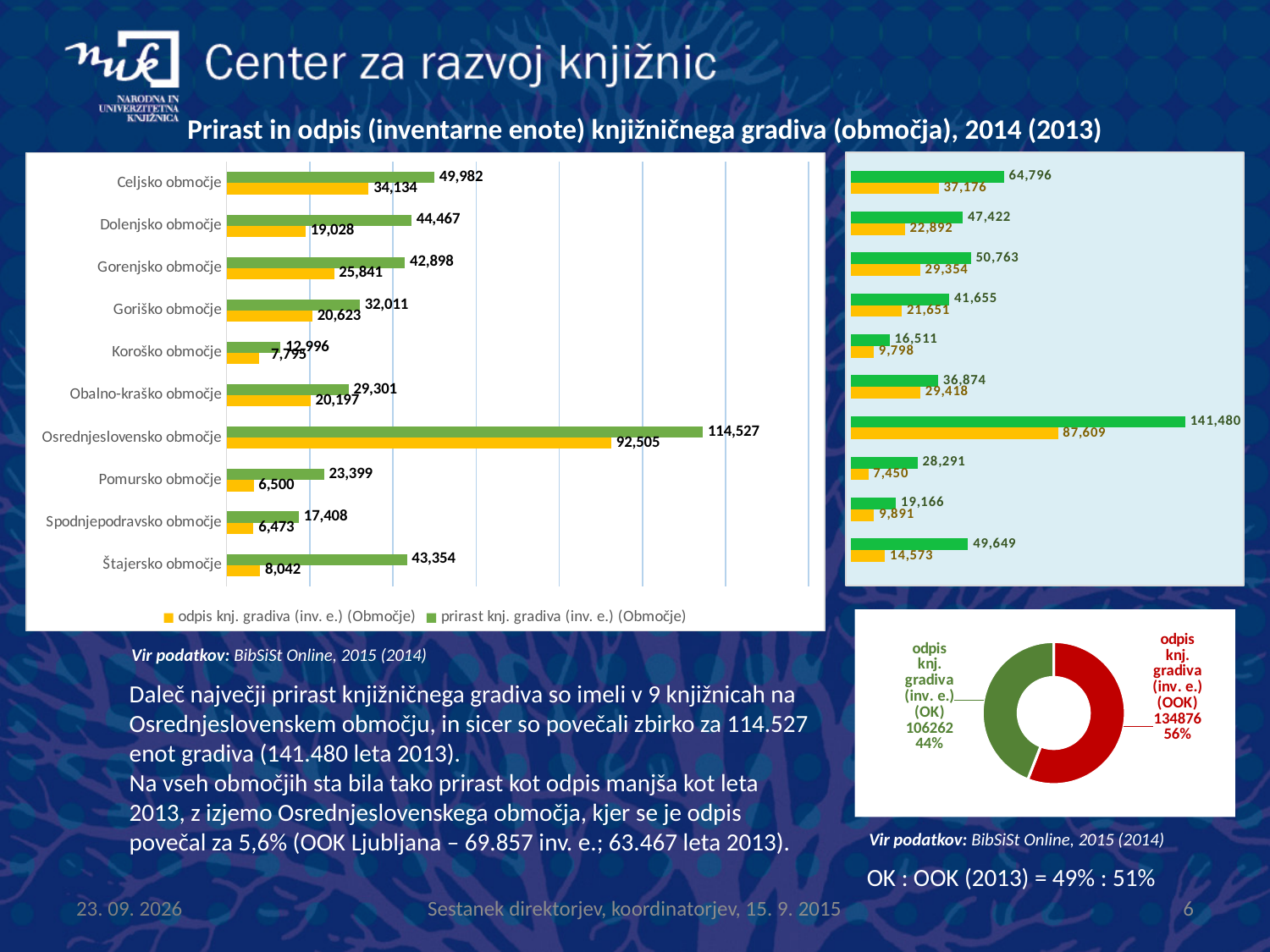
How many območja (categories) are shown in the left bar chart? 10 In the doughnut chart at the bottom right, what is the value for odpis knj. gradiva (inv. e.) (OK)? 106262 In the left bar chart, which is larger: the odpis value for Gorenjsko območje or the odpis value for Goriško območje? Gorenjsko območje In the left bar chart, which območje has the highest prirast knj. gradiva value? Osrednjeslovensko območje In the left bar chart, what is the odpis knj. gradiva value for Celjsko območje? 34,134 In the left bar chart, what is the difference between prirast and odpis for Štajersko območje? 35,312 In the left bar chart, which območje has the lowest prirast knj. gradiva value? Koroško območje In the left bar chart, what is the prirast knj. gradiva value for Osrednjeslovensko območje? 114,527 How many series does the legend of the left bar chart list? 2 In the doughnut chart at the bottom right, what share does odpis knj. gradiva (inv. e.) (OOK) have? 56% What type of chart is the chart on the left of the slide? Bar chart In the left bar chart, what colour are the bars for odpis knj. gradiva (inv. e.) (Območje)? Yellow